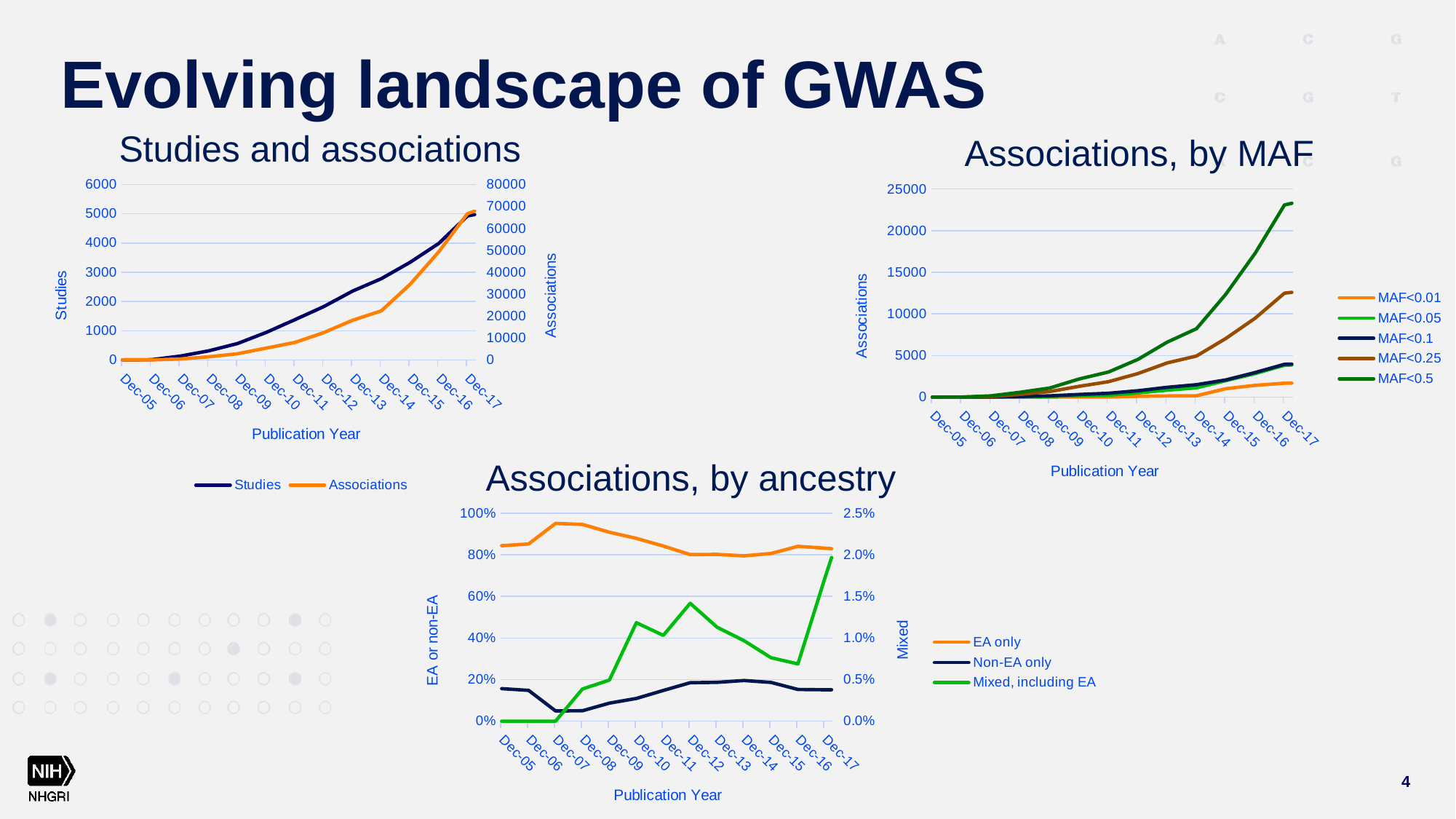
In the 'Studies and associations' chart, how many publication years are plotted along the x axis? 13 In the 'Studies and associations' chart, do the Studies values rise or fall from Dec-05 to Dec-17? rise In the 'Associations, by MAF' chart, is the MAF<0.25 value at Dec-17 greater or less than 10000? greater In the 'Associations, by MAF' chart, which series has the lowest value at Dec-17? MAF<0.01 In the 'Associations, by MAF' chart, which series has the highest value at Dec-17? MAF<0.5 In the 'Associations, by ancestry' chart, is the EA only value at Dec-07 greater or less than 80%? greater How many series does the legend of the 'Associations, by MAF' chart list? 5 What kind of chart is the 'Studies and associations' chart? line chart How many series does the legend of the 'Studies and associations' chart list? 2 In the 'Associations, by MAF' chart, is the MAF<0.5 value at Dec-17 greater or less than 20000? greater How many series does the legend of the 'Associations, by ancestry' chart list? 3